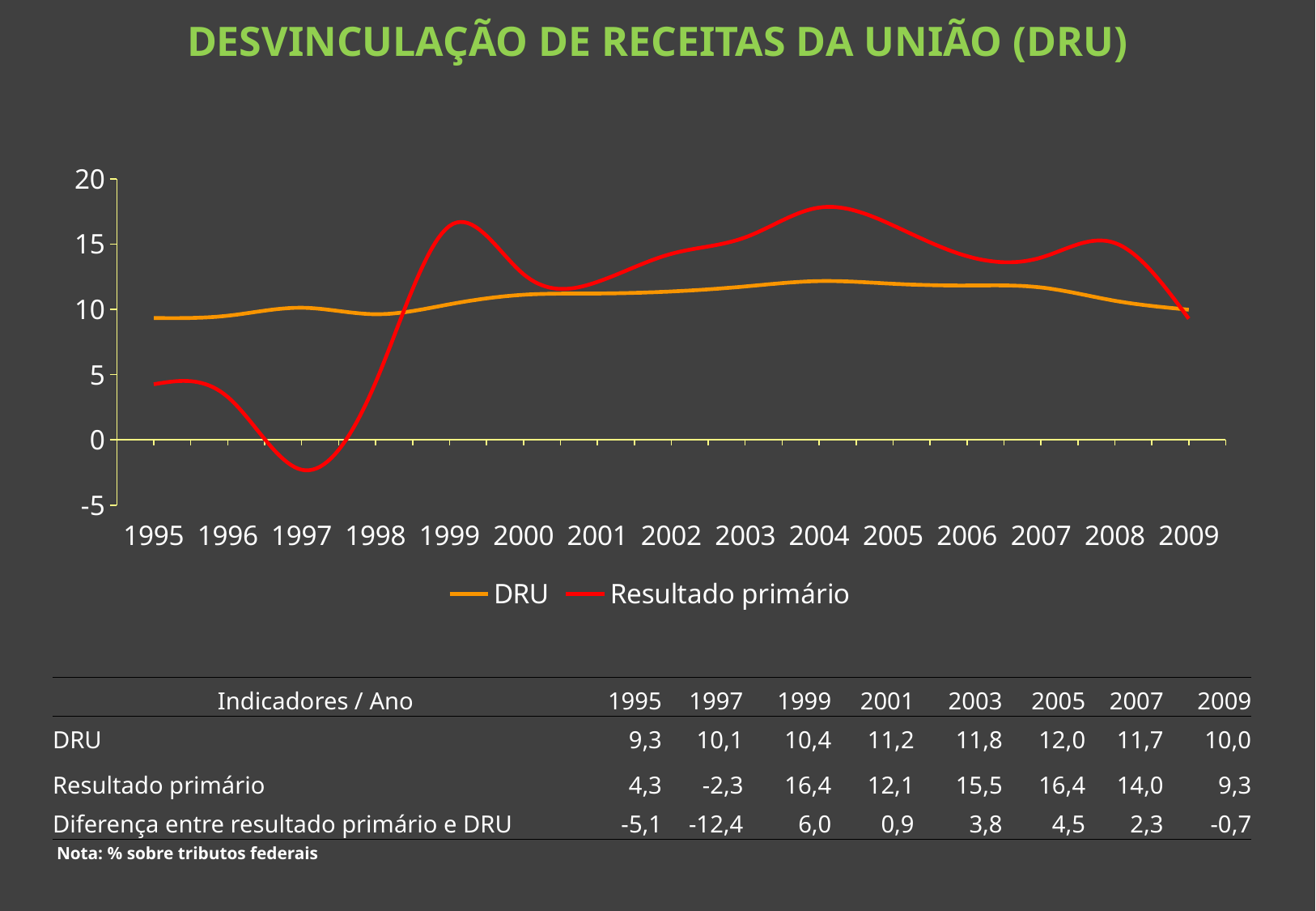
What colour is the DRU line in the chart? orange How many series does the legend list? 2 What is the Resultado primário value for 1997? -2,3 In 1997, which is larger, DRU or Resultado primário? DRU How many years are shown on the x axis of the chart? 15 Is the Resultado primário value for 2004 greater or less than 15? greater What kind of chart is shown on the slide? line chart In which year is Resultado primário at its lowest? 1997 What is the DRU value for 1995? 9,3 What is the DRU value for 2005? 12,0 By how much did DRU increase from 1995 to 2005? 2,7